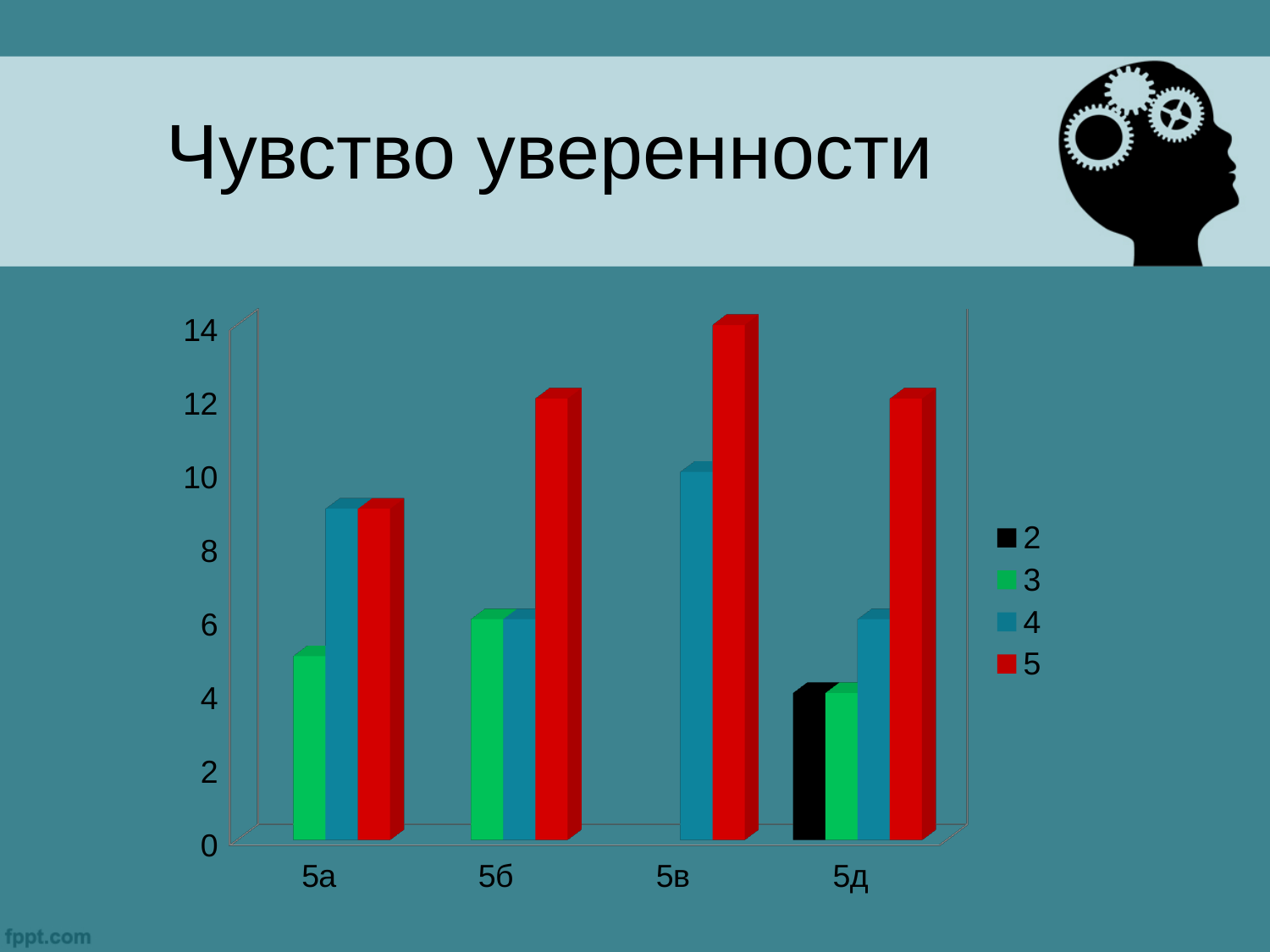
Which is larger in category 5д: the value for series 4 or the value for series 5? series 5 Is the value for series 3 in category 5а greater or less than 6? less What is the title of the chart? Чувство уверенности How many categories are shown on the x axis? 4 Is the value for series 5 in category 5в greater or less than 12? greater Which category is the only one with a bar for series 2? 5д Which category has the highest value for series 5? 5в Is the value for series 4 in category 5а greater or less than 8? greater Which category has the lowest value for series 5? 5а What kind of chart is shown on the slide? bar chart How many series does the legend list? 4